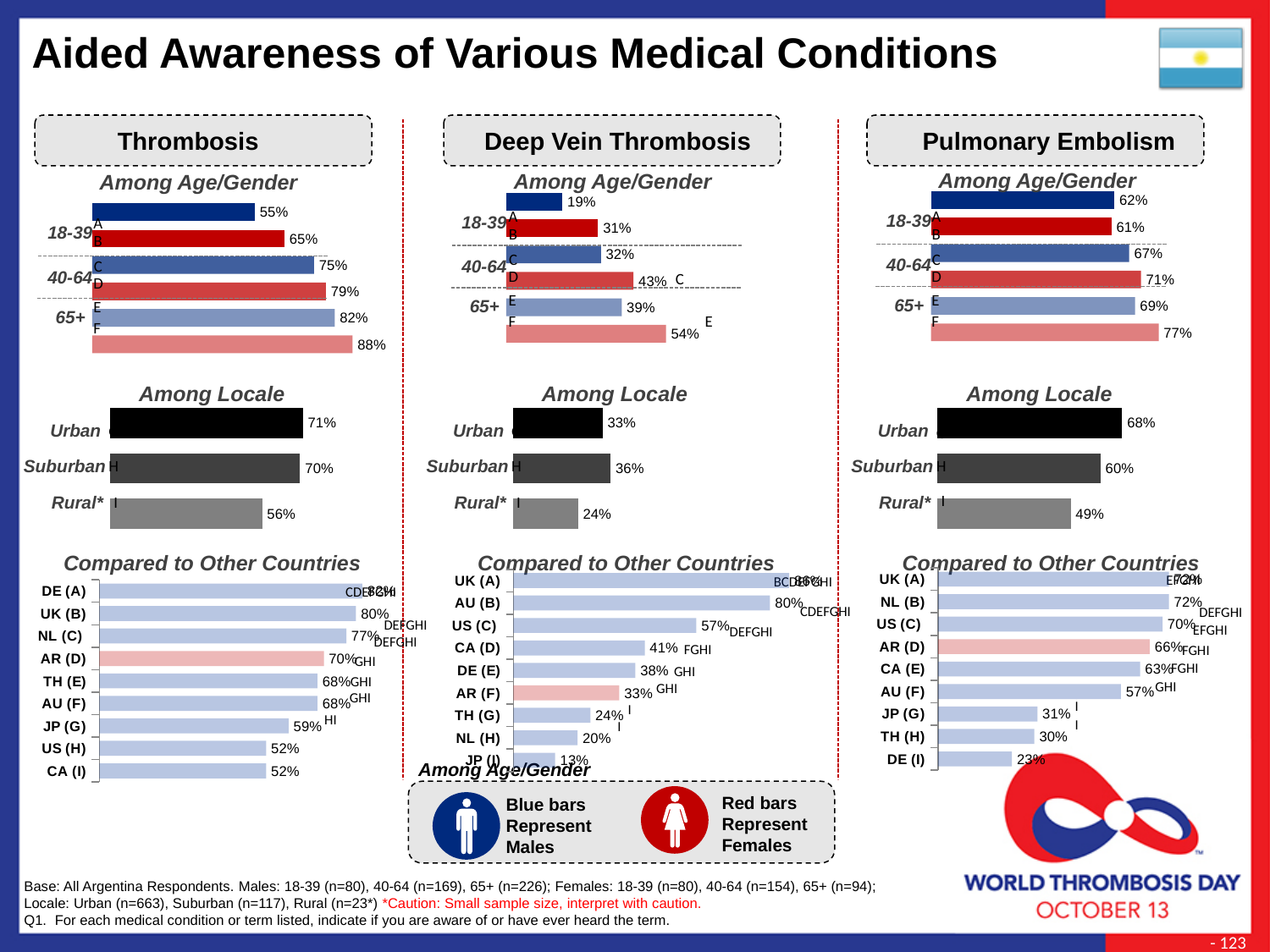
In the Deep Vein Thrombosis 'Among Locale' chart, which locale has the lowest value? Rural* In the Deep Vein Thrombosis 'Among Age/Gender' chart, what is the value for males aged 18-39 (bar A)? 19% In the Thrombosis 'Among Locale' chart, what is the value for Rural? 56% In the Deep Vein Thrombosis 'Compared to Other Countries' chart, what is the value for AR (F)? 33% In the Pulmonary Embolism 'Among Age/Gender' chart, which is larger: the value for bar D (females 40-64) or bar E (males 65+)? D (females 40-64) How many countries are listed in the Pulmonary Embolism 'Compared to Other Countries' chart? 9 In the Thrombosis 'Among Age/Gender' chart, what is the value for females aged 65+ (bar F)? 88% In the Thrombosis 'Among Locale' chart, which locale has the highest value? Urban In the Deep Vein Thrombosis 'Compared to Other Countries' chart, which country has the lowest value? JP (I) What type of chart is used for the Thrombosis 'Among Locale' section? Bar chart In the Pulmonary Embolism 'Among Locale' chart, what is the value for Suburban? 60% In the Deep Vein Thrombosis 'Among Age/Gender' chart, what is the difference between females aged 65+ (F) and males aged 65+ (E)? 15%